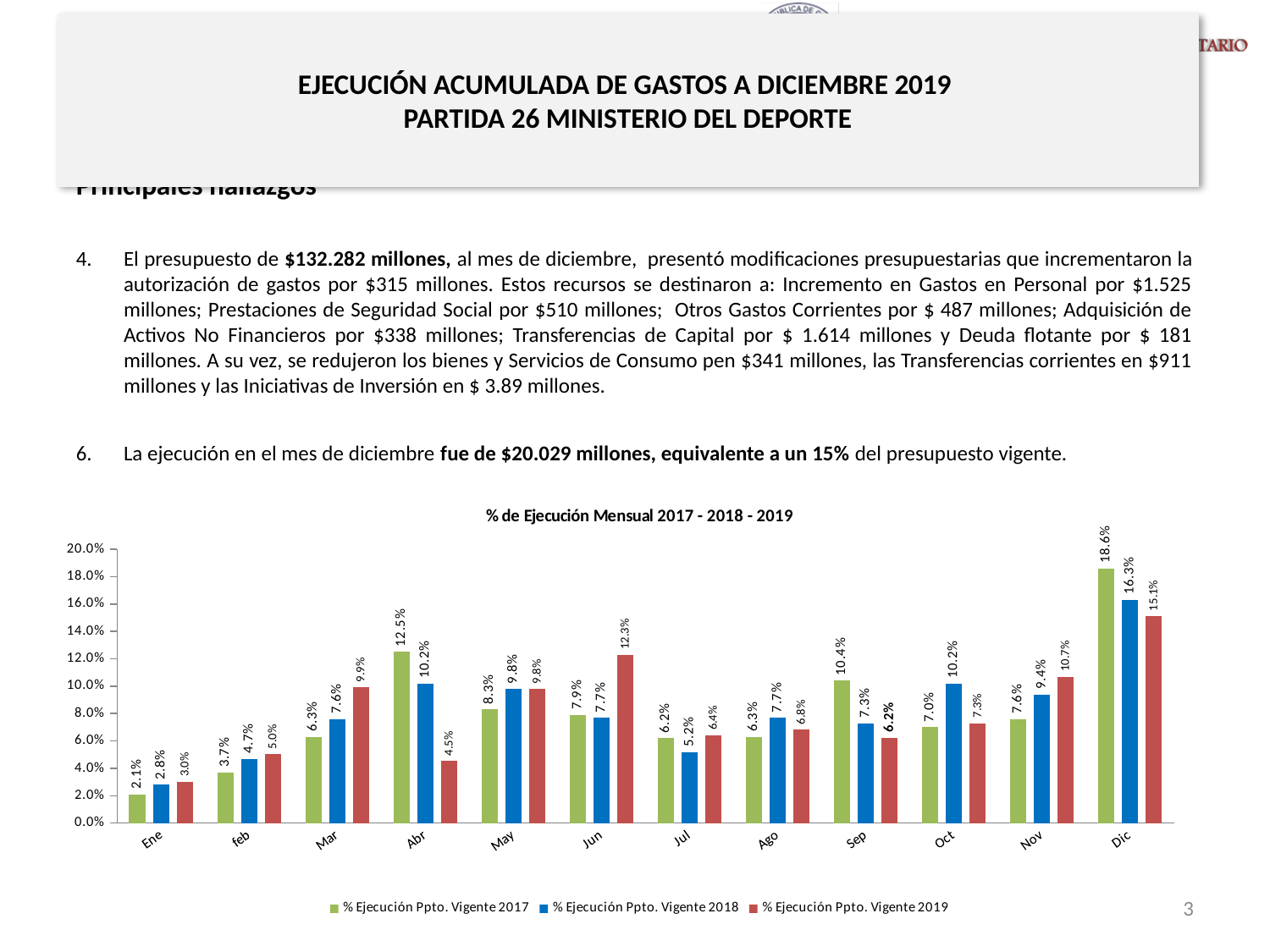
In Jun, which is larger: the 2018 value or the 2019 value? 2019 value Is the value for % Ejecución Ppto. Vigente 2018 in Dic greater or less than 14.0%? greater What is the value for % Ejecución Ppto. Vigente 2019 in Dic? 15.1% What is the title of the chart? % de Ejecución Mensual 2017 - 2018 - 2019 How many series does the legend list? 3 Which month has the highest value for % Ejecución Ppto. Vigente 2017? Dic What kind of chart is shown on the slide? Bar chart Which month has the lowest value for % Ejecución Ppto. Vigente 2019? Ene How many months are shown on the x axis? 12 What is the value for % Ejecución Ppto. Vigente 2018 in Oct? 10.2% What is the difference between the 2017 and 2019 values in Dic? 3.5% What is the value for % Ejecución Ppto. Vigente 2017 in Abr? 12.5%